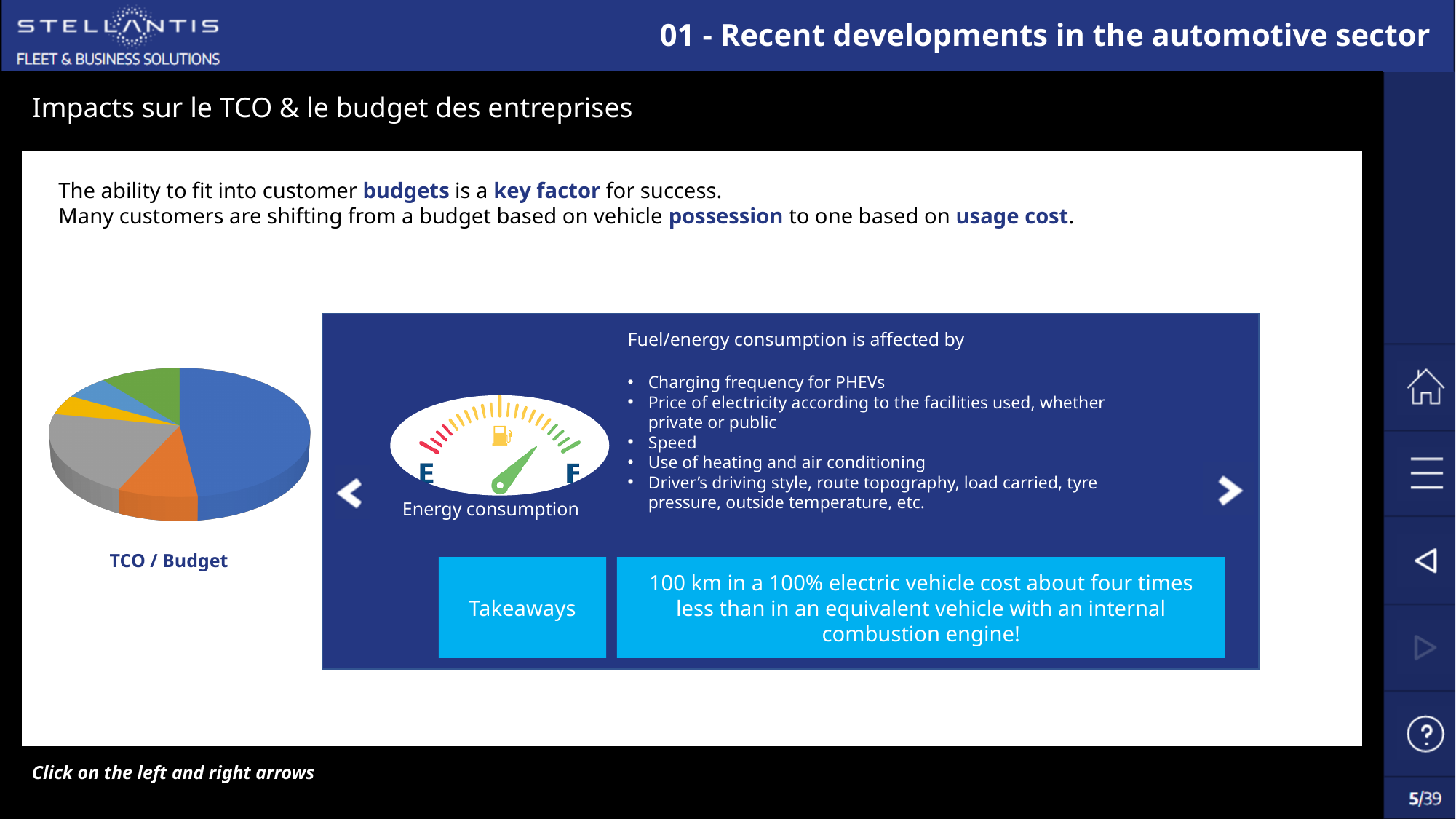
What is the label shown beneath the pie chart? TCO / Budget How many slices does the "TCO / Budget" pie chart have? 6 What kind of chart is shown on the left of the slide under the label "TCO / Budget"? Pie chart In the "TCO / Budget" pie chart, is the blue slice larger or smaller than the green slice? Larger Which colour slice is the largest in the "TCO / Budget" pie chart? Blue